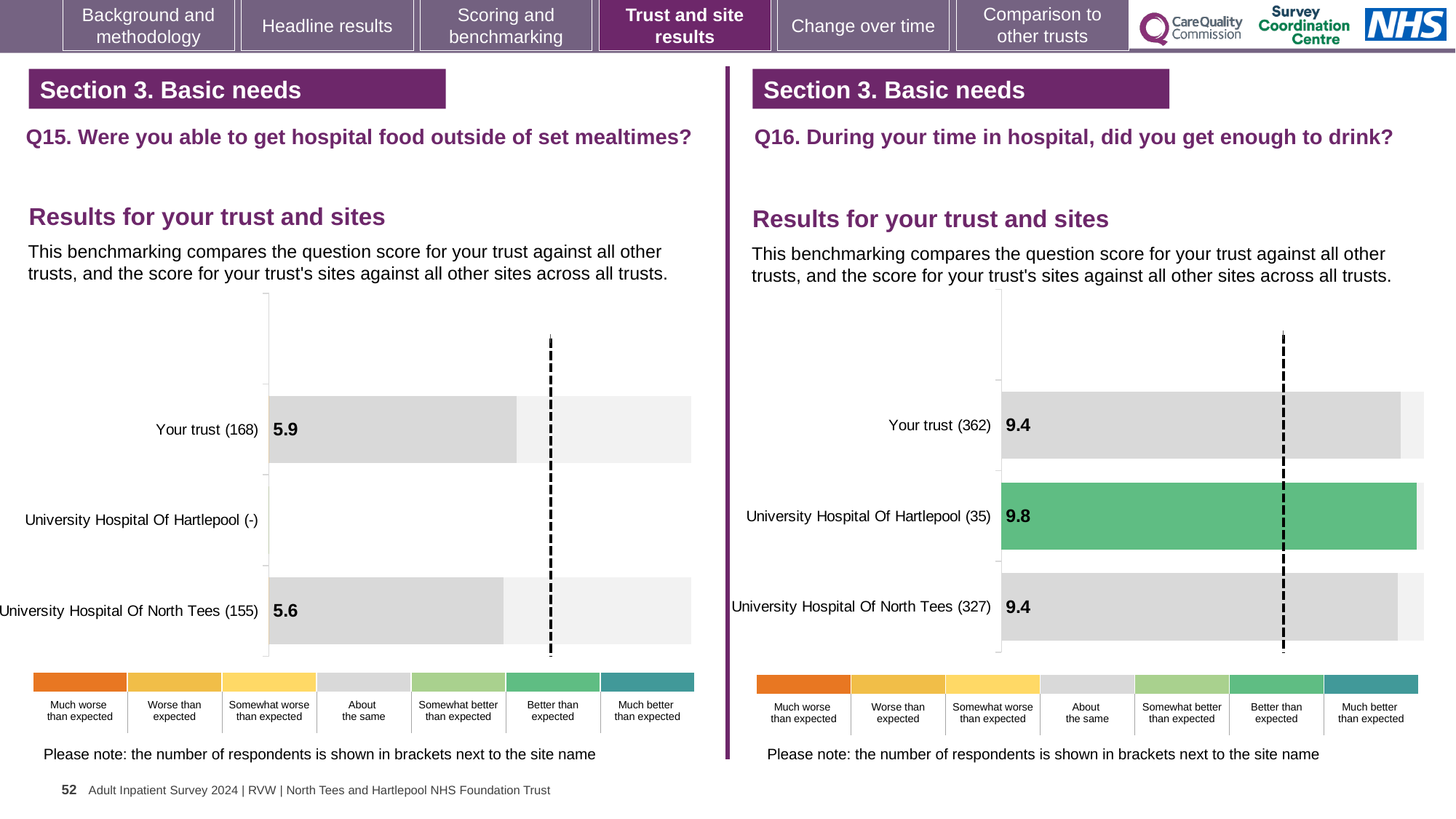
In the Q16 chart (right), which site or trust has the highest score? University Hospital Of Hartlepool In the Q15 chart (left), what is the score for Your trust? 5.9 In the Q16 chart (right), which site's bar is coloured green? University Hospital Of Hartlepool In the Q15 chart (left), what is the difference between the score for Your trust and the score for University Hospital Of North Tees? 0.3 In the Q15 chart (left), what is the score for University Hospital Of North Tees? 5.6 In the Q15 chart (left), how many respondents are shown for University Hospital Of North Tees? 155 In the Q16 chart (right), what is the difference between the score for University Hospital Of Hartlepool and the score for Your trust? 0.4 In the Q16 chart (right), what is the score for University Hospital Of North Tees? 9.4 What kind of chart is used in the Q16 chart (right)? Bar chart In the Q16 chart (right), how many respondents are shown for Your trust? 362 In the Q16 chart (right), what is the score for University Hospital Of Hartlepool? 9.8 In the Q15 chart (left), which is larger: the score for Your trust or the score for University Hospital Of North Tees? Your trust